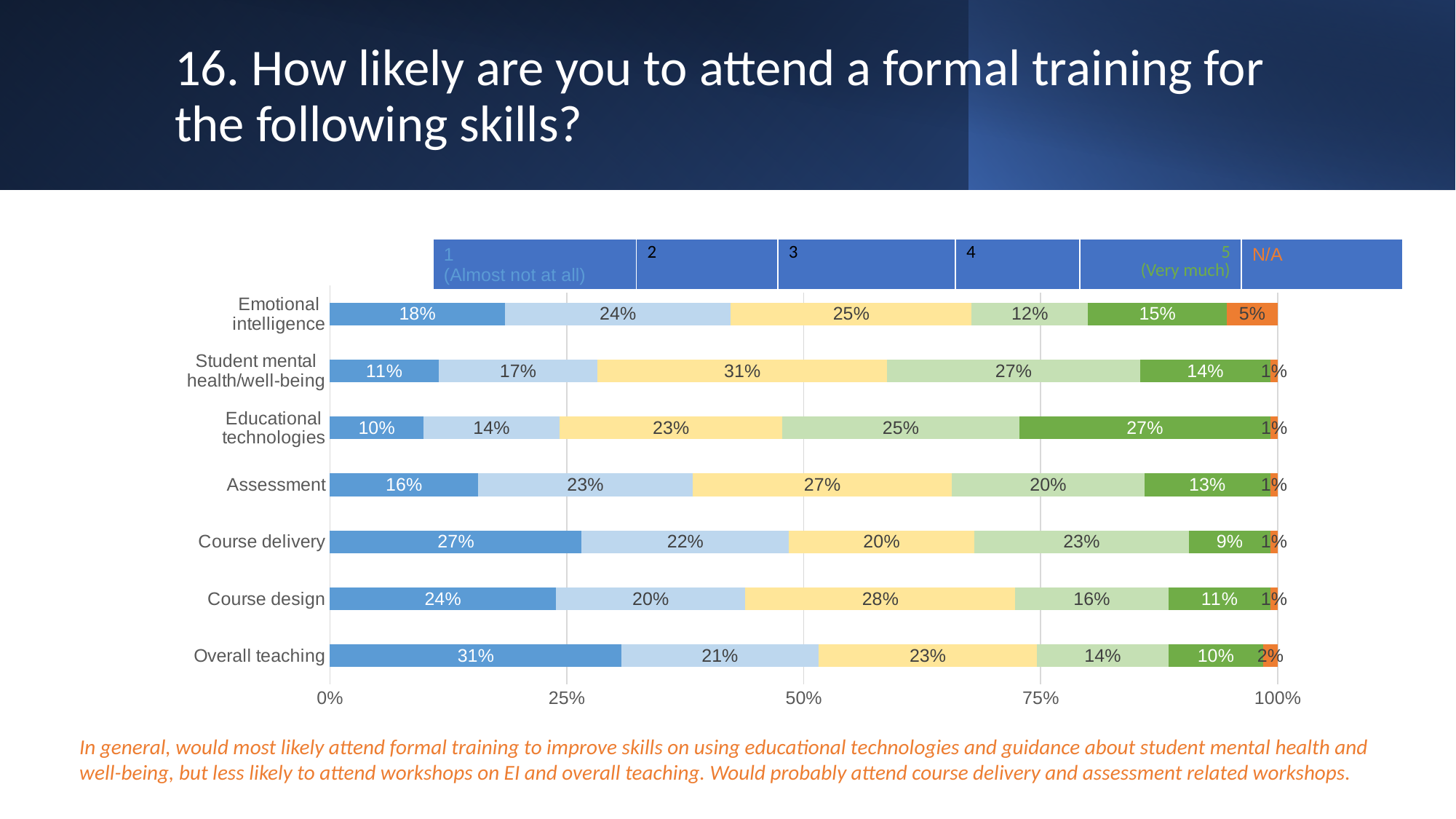
What percentage of respondents chose "1 (Almost not at all)" for Overall teaching? 31% How many series does the legend list? 6 Which skill has the lowest percentage for "5 (Very much)"? Course delivery How many skills are listed on the chart? 7 What percentage of respondents chose "5 (Very much)" for Educational technologies? 27% What is the N/A percentage for Emotional intelligence? 5% Which skill has the highest percentage for "1 (Almost not at all)"? Overall teaching How many percentage points higher is the "5 (Very much)" share for Educational technologies than for Course delivery? 18 percentage points Which skill has the highest percentage for "5 (Very much)"? Educational technologies What type of chart is shown on the slide? Stacked bar chart Which has a larger "1 (Almost not at all)" share: Course delivery or Course design? Course delivery What percentage of respondents chose "3" for Student mental health/well-being? 31%